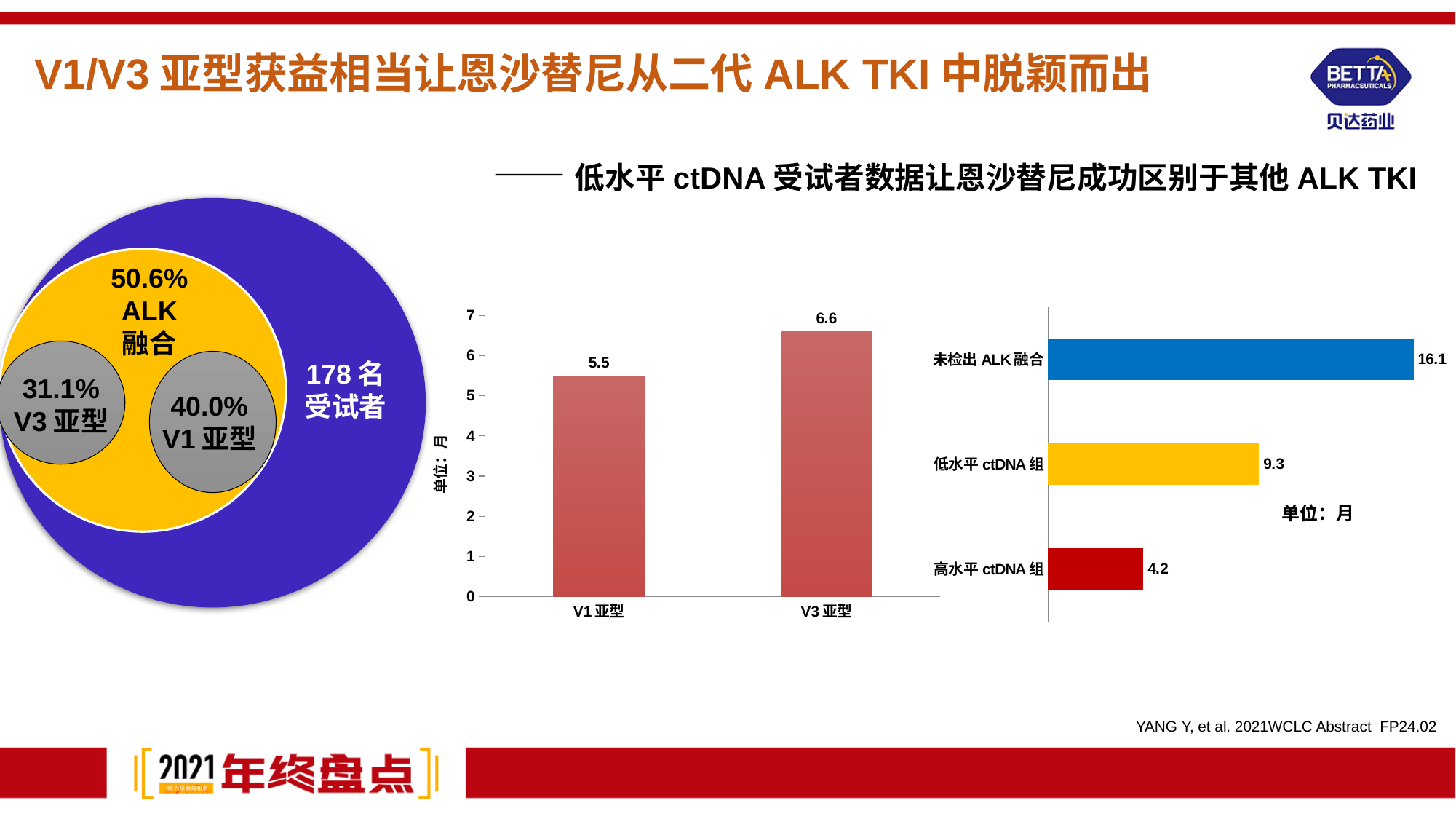
In the right-hand horizontal bar chart, which category has the lowest value? 高水平 ctDNA 组 In the middle bar chart, how many categories are plotted? 2 In the middle bar chart, what is the value for V1 亚型? 5.5 In the middle bar chart, which category has the higher value, V1 亚型 or V3 亚型? V3 亚型 In the right-hand horizontal bar chart, what is the difference between the values for 未检出 ALK 融合 and 高水平 ctDNA 组? 11.9 What kind of chart is the right-hand chart on the slide? Bar chart In the right-hand horizontal bar chart, what is the value for 低水平 ctDNA 组? 9.3 In the middle bar chart, what is the value for V3 亚型? 6.6 In the middle bar chart, what unit is shown on the vertical axis label? 月 In the middle bar chart, what is the difference between the values for V3 亚型 and V1 亚型? 1.1 In the right-hand horizontal bar chart, what is the value for 高水平 ctDNA 组? 4.2 In the right-hand horizontal bar chart, what is the value for 未检出 ALK 融合? 16.1